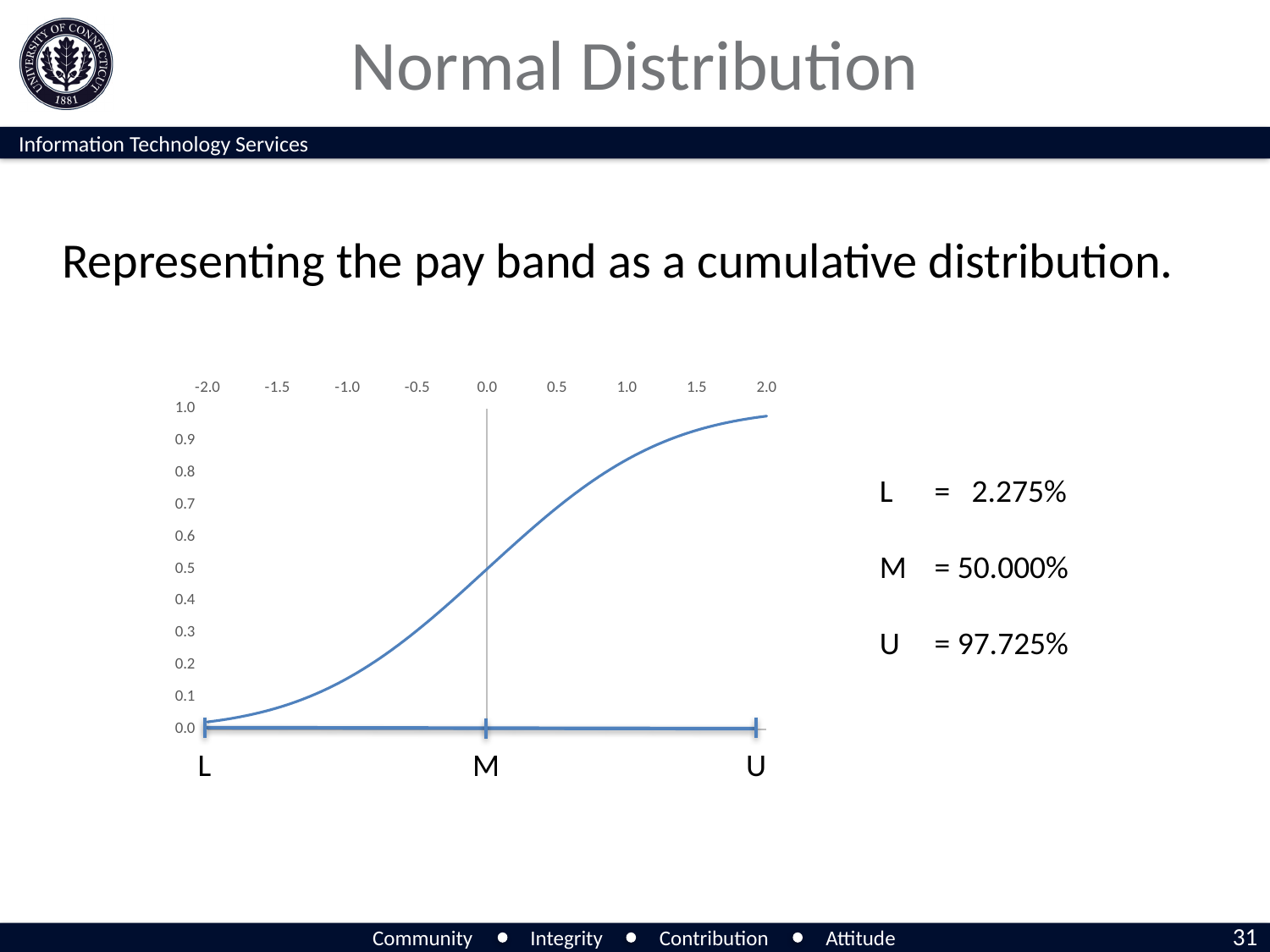
What kind of chart is shown on the slide? line chart How many tick labels are shown along the x axis of the chart? 9 According to the slide, what percentage corresponds to L? 2.275% What are the three labels shown beneath the chart's x axis? L, M, U What is the value of the curve at x = 0.0 (the point labelled M)? 0.5 Is the value of the curve at x = 1.0 greater or less than 0.7? greater Does the plotted curve rise or fall as the x axis goes from -2.0 to 2.0? rise Is the value of the curve at x = -1.0 greater or less than 0.3? less According to the slide, what percentage corresponds to U? 97.725% Is the value of the curve at x = -2.0 (the point labelled L) greater or less than 0.1? less Which is larger, the value of the curve at x = -0.5 or at x = 0.5? x = 0.5